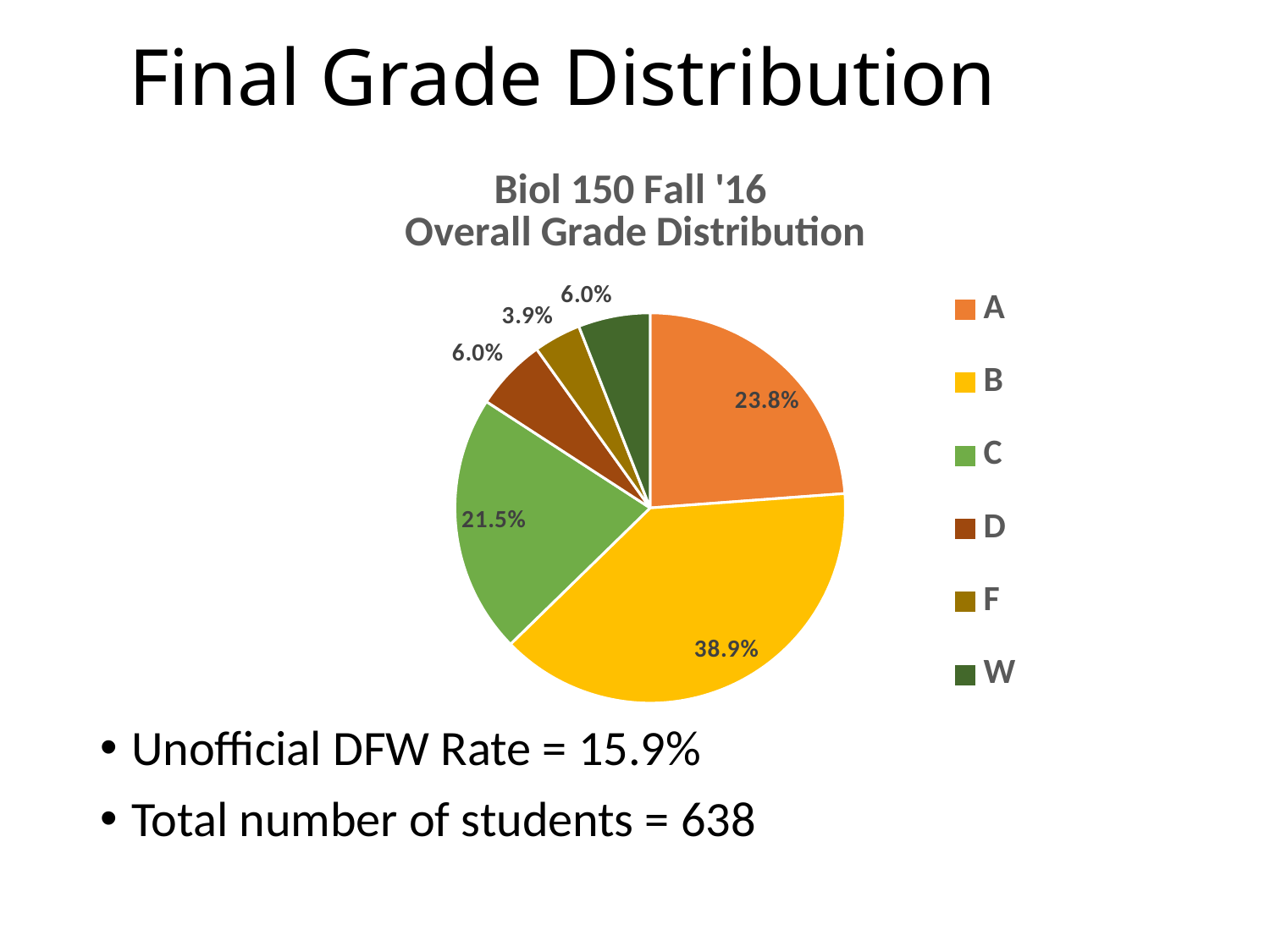
How many grade categories does the legend list? 6 What type of chart is shown on the slide? pie chart Which grade has the smallest share of the pie? F What colour is the slice for grade C? green Which grade has the largest share of the pie? B Which is larger, the share for A or the share for C? A What is the difference in percentage points between the B share and the A share? 15.1 What percentage of students received a C? 21.5% What is the title of the chart? Biol 150 Fall '16 Overall Grade Distribution What percentage of students received an F? 3.9% What percentage of students received a B? 38.9% What percentage of students received an A? 23.8%